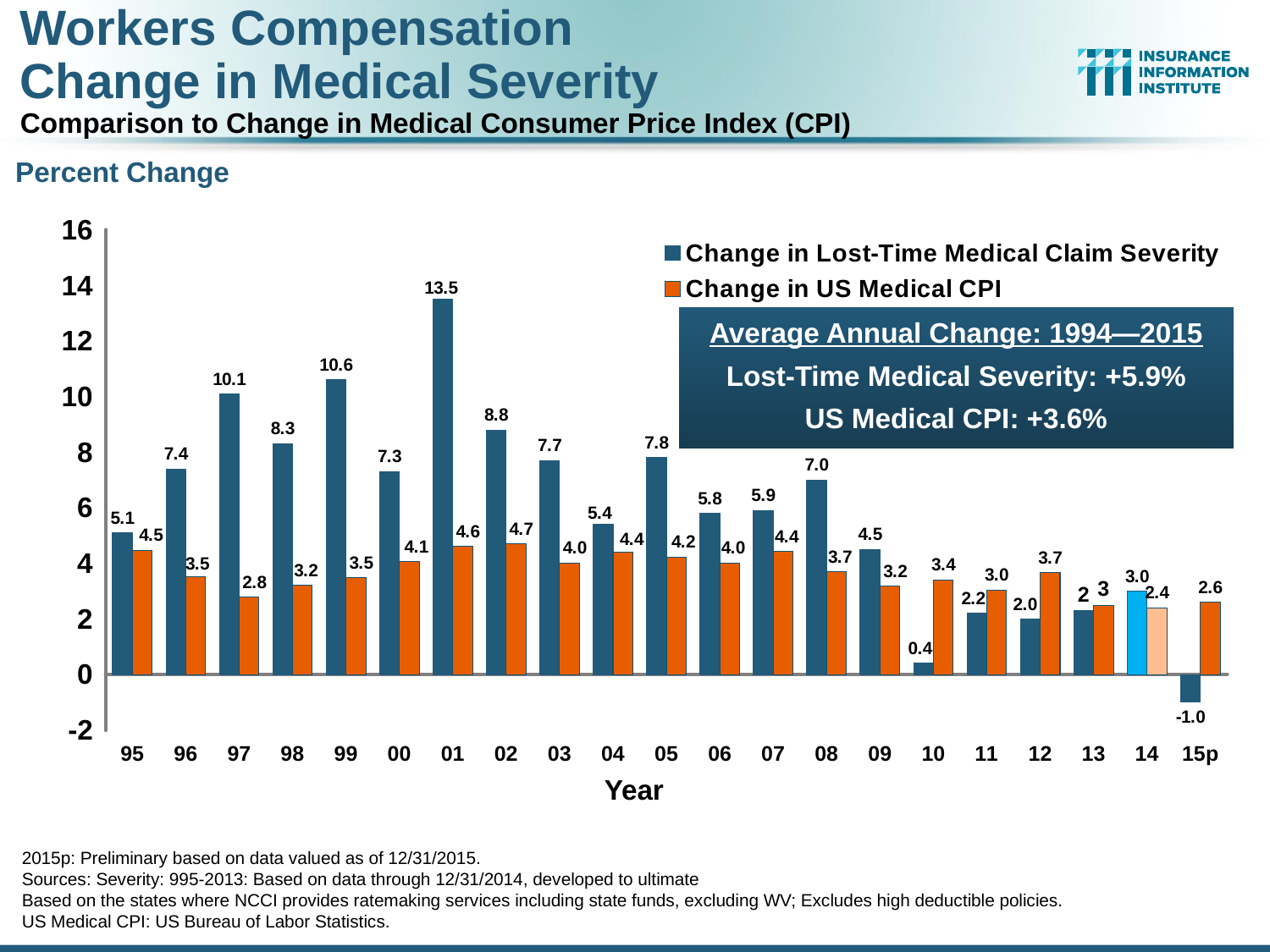
How many series does the legend list? 2 How many years are shown on the x axis? 21 Which year has the lowest Change in Lost-Time Medical Claim Severity? 15p Which year has the highest Change in US Medical CPI? 02 What is the Change in Lost-Time Medical Claim Severity for 01? 13.5 In 10, which is larger: the Change in Lost-Time Medical Claim Severity or the Change in US Medical CPI? Change in US Medical CPI What kind of chart is shown on the slide? Bar chart Which year has the highest Change in Lost-Time Medical Claim Severity? 01 What is the Change in Lost-Time Medical Claim Severity for 15p? -1.0 What is the Change in US Medical CPI for 97? 2.8 What is the difference between the Change in Lost-Time Medical Claim Severity and the Change in US Medical CPI in 99? 7.1 According to the text box on the chart, what is the average annual change in US Medical CPI for 1994—2015? +3.6%